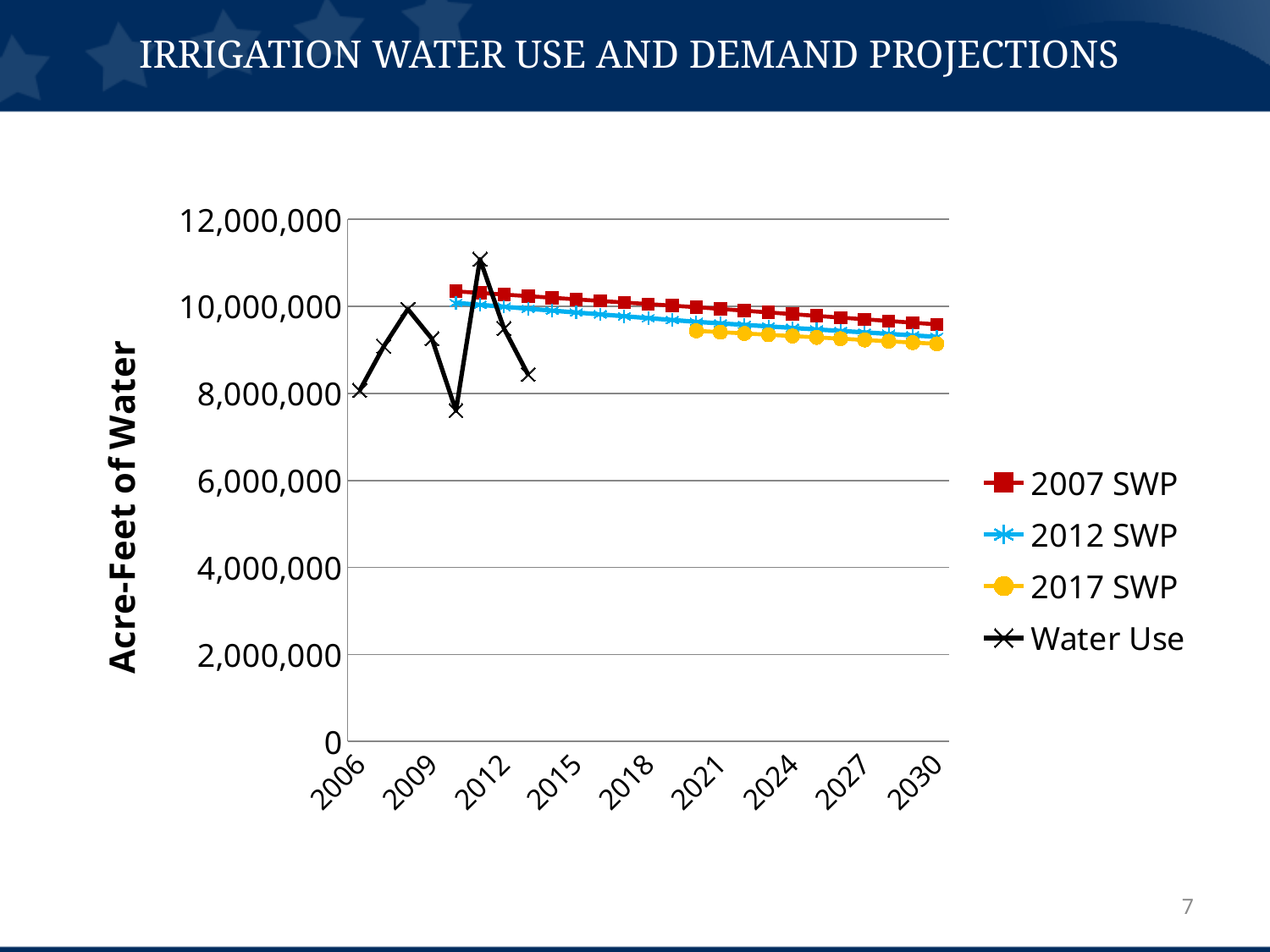
Which series has the lowest value in 2030? 2017 SWP Do the 2012 SWP values rise or fall from 2010 to 2030? fall Which series is plotted with black x markers? Water Use Is the 2017 SWP value for 2021 greater or less than 10,000,000? less What is the title of the vertical axis? Acre-Feet of Water What kind of chart is shown on the slide? line chart Is the Water Use value for 2006 greater or less than 10,000,000? less How many series does the legend list? 4 Do the 2007 SWP values rise or fall from 2010 to 2030? fall In 2030, which is larger: the 2007 SWP value or the 2017 SWP value? 2007 SWP Is the 2007 SWP value for 2030 greater or less than 8,000,000? greater